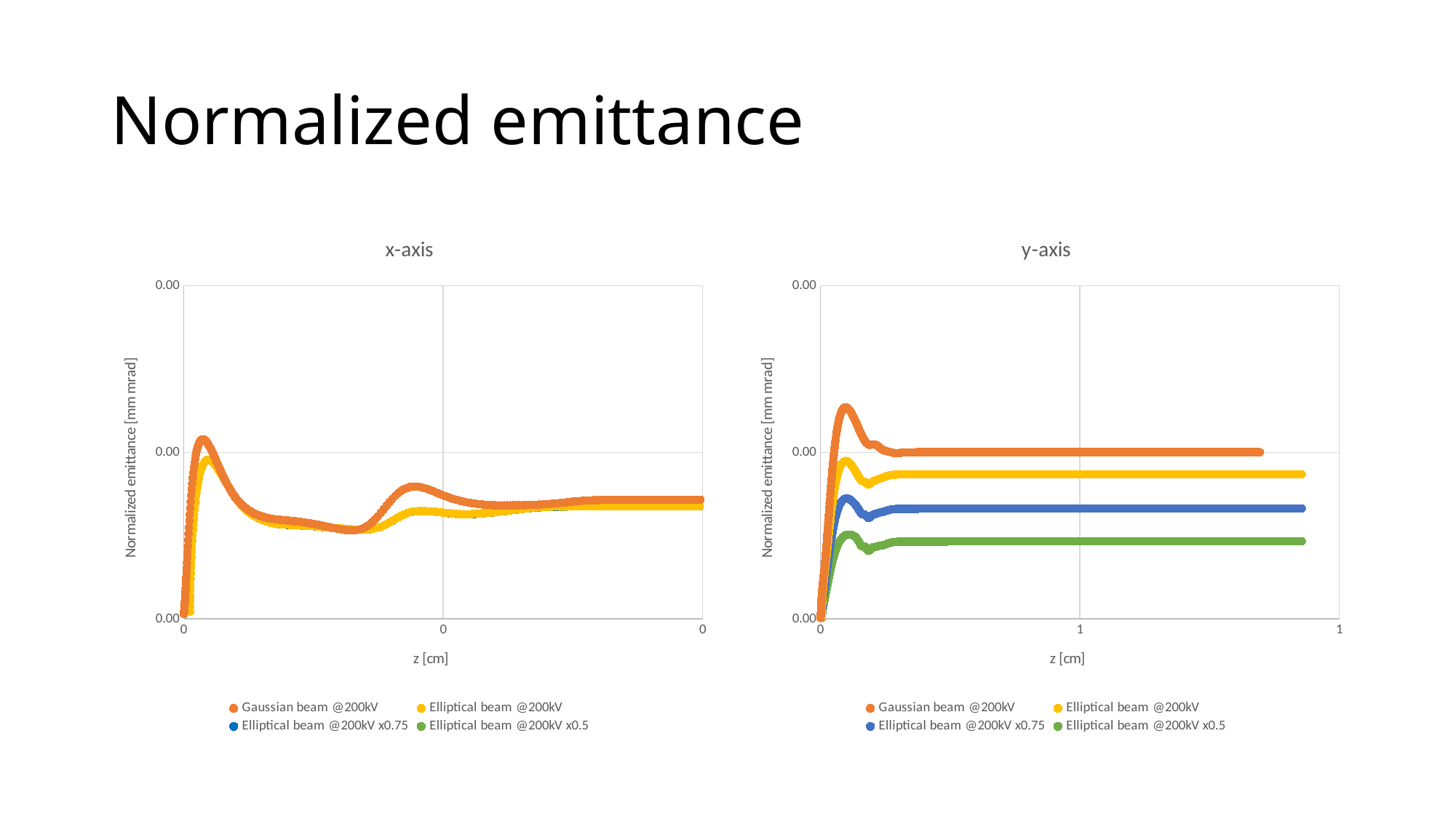
In the chart titled "y-axis", do the values of the Gaussian beam @200kV series rise or fall after their initial peak near small z? fall What is the x-axis label of the chart titled "x-axis"? z [cm] In the chart titled "y-axis", which series has the highest plateau value at large z? Gaussian beam @200kV In the chart titled "y-axis", which series has the lowest plateau value at large z? Elliptical beam @200kV x0.5 What is the y-axis label of the chart titled "y-axis"? Normalized emittance [mm mrad] How many series does the legend of the chart titled "x-axis" list? 4 In the chart titled "y-axis", is the plateau value of Gaussian beam @200kV larger or smaller than that of Elliptical beam @200kV x0.5? larger In the chart titled "y-axis", is the plateau value of Elliptical beam @200kV x0.75 larger or smaller than that of Elliptical beam @200kV? smaller What kind of chart is the chart titled "x-axis"? scatter chart How many series does the legend of the chart titled "y-axis" list? 4 In the chart titled "x-axis", which series reaches the higher initial peak near small z, Gaussian beam @200kV or Elliptical beam @200kV? Gaussian beam @200kV